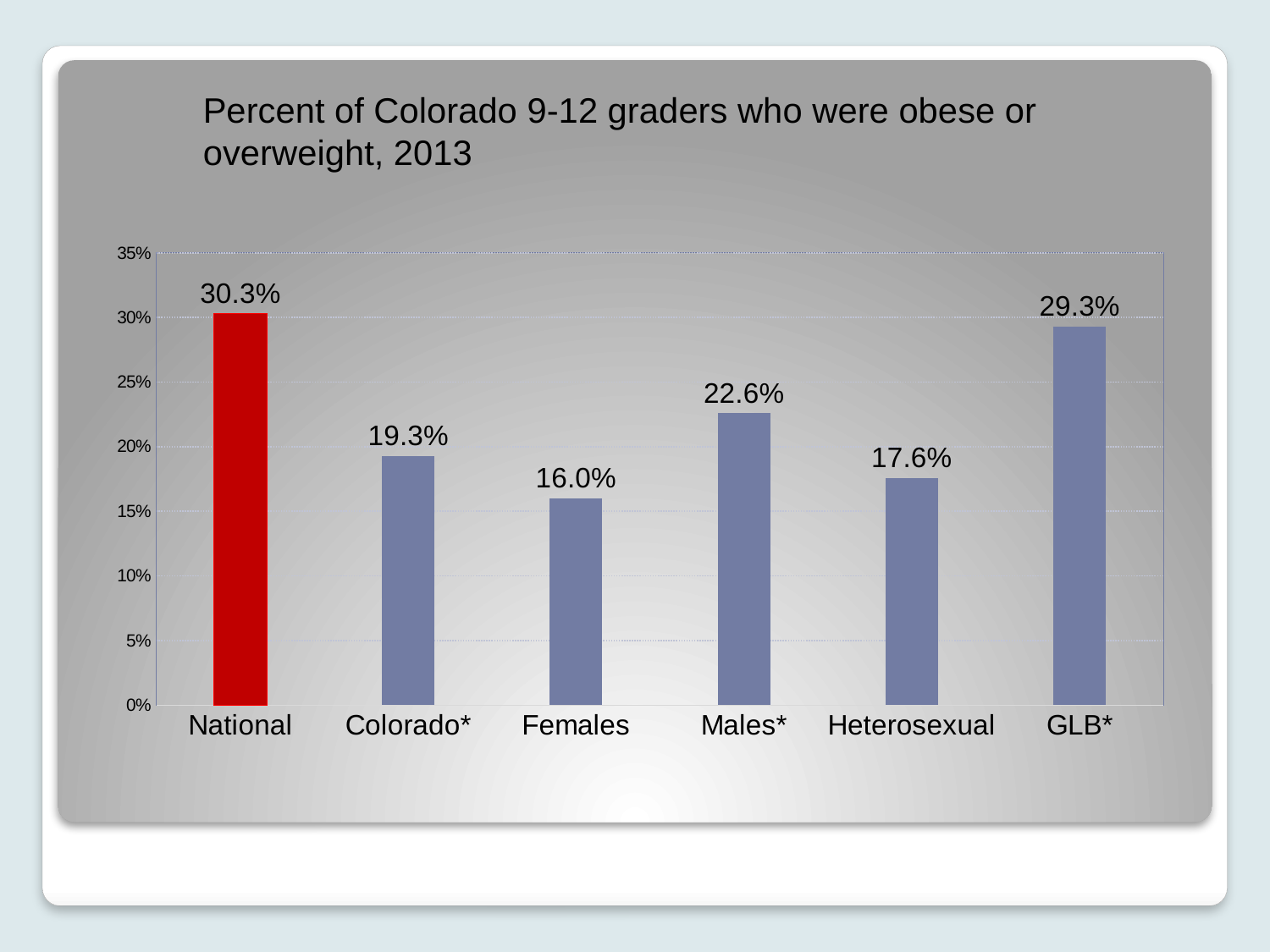
Is the value for Males* greater or less than 20%? greater Which category has the highest value? National What is the value for Colorado*? 19.3% What kind of chart is shown on the slide? bar chart Which bar is coloured red rather than blue? National Which is larger, the value for Colorado* or the value for Heterosexual? Colorado* How many categories are shown on the x axis? 6 What is the value for National? 30.3% What is the difference between the values for Males* and Females? 6.6% What is the value for GLB*? 29.3% What is the difference between the values for GLB* and Heterosexual? 11.7% Which category has the lowest value? Females